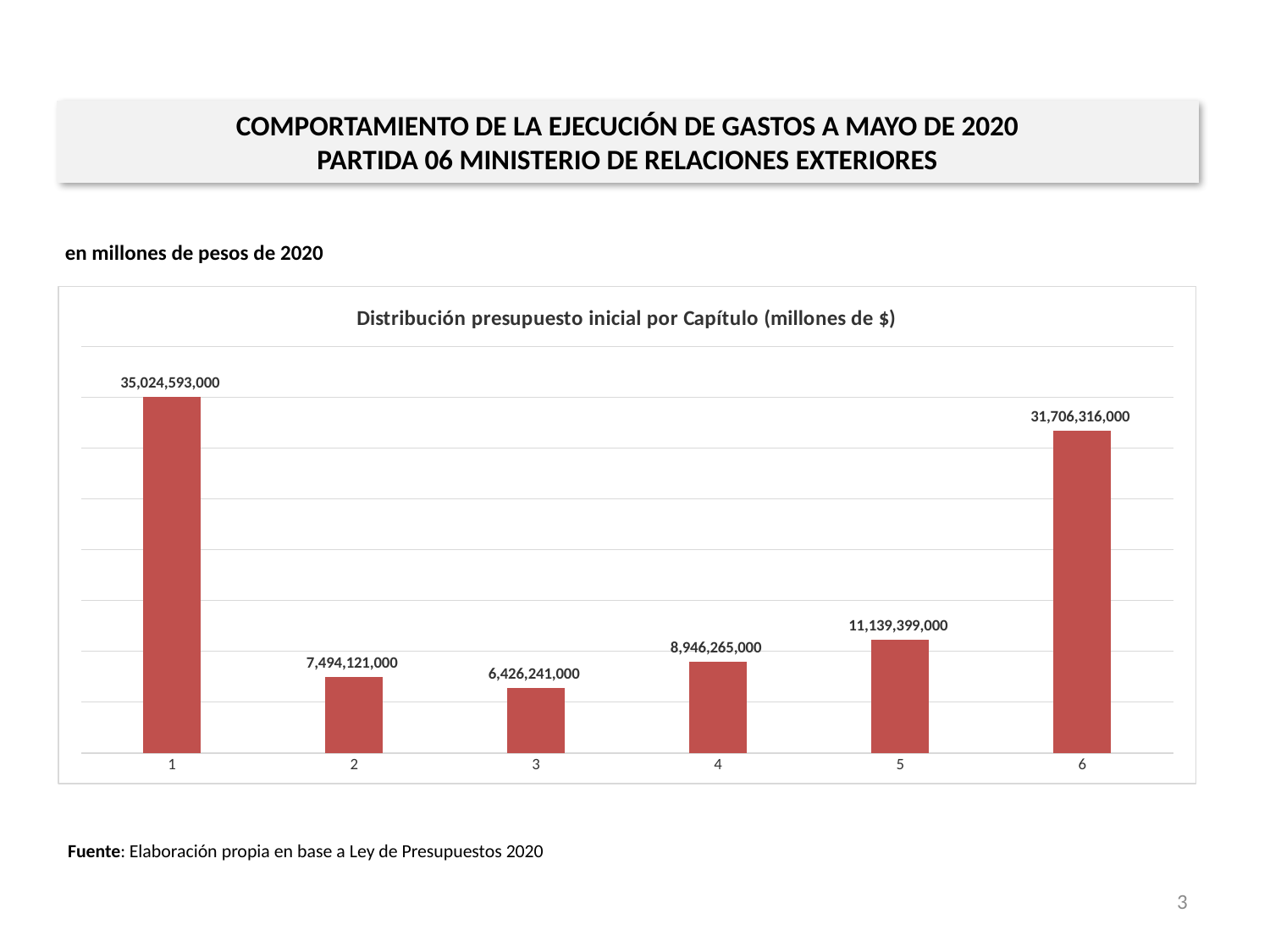
What is the value for category 1 in the chart? 35,024,593,000 What is the value for category 6 in the chart? 31,706,316,000 Which is larger, the value for category 2 or the value for category 4? 4 How many categories are shown in the chart? 6 What kind of chart is shown on the slide? Bar chart What is the difference between the values for category 5 and category 4? 2,193,134,000 What is the difference between the values for category 1 and category 6? 3,318,277,000 Which category has the lowest value in the chart? 3 What is the title of the chart? Distribución presupuesto inicial por Capítulo (millones de $) What is the value for category 3 in the chart? 6,426,241,000 Which category has the highest value in the chart? 1 What is the value for category 5 in the chart? 11,139,399,000